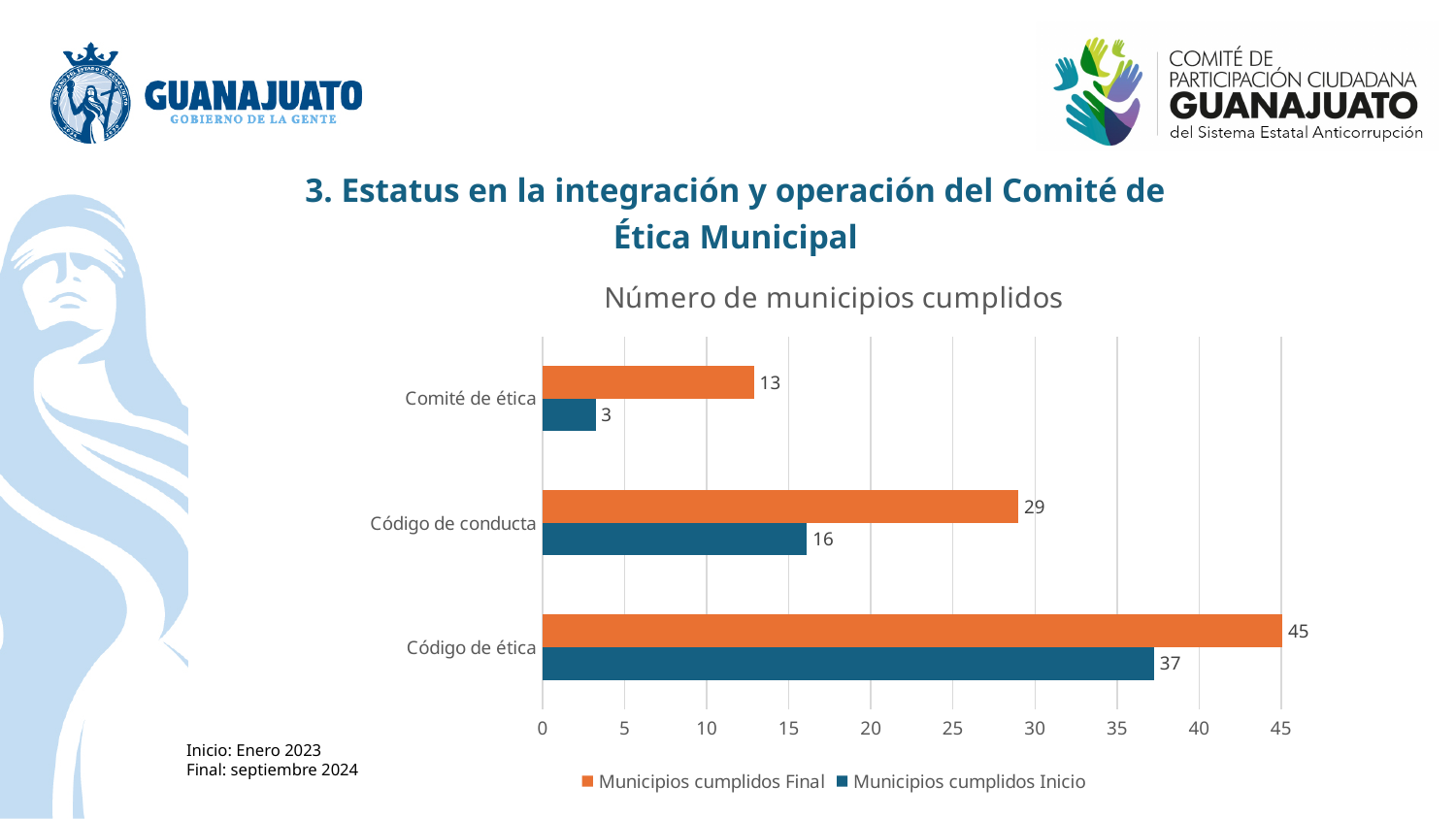
Which category has the lowest value for Municipios cumplidos Inicio? Comité de ética Which category has the highest value for Municipios cumplidos Final? Código de ética What is the difference between Municipios cumplidos Final and Municipios cumplidos Inicio for Código de conducta? 13 What is the difference between Municipios cumplidos Final and Municipios cumplidos Inicio for Comité de ética? 10 What kind of chart is shown on the slide? Bar chart What is the value of Municipios cumplidos Inicio for Código de conducta? 16 Which is larger: Municipios cumplidos Inicio for Código de ética or Municipios cumplidos Final for Código de conducta? Municipios cumplidos Inicio for Código de ética How many categories are shown on the chart? 3 What is the value of Municipios cumplidos Final for Código de ética? 45 What is the value of Municipios cumplidos Inicio for Comité de ética? 3 How many series does the legend list? 2 What is the title of the chart? Número de municipios cumplidos